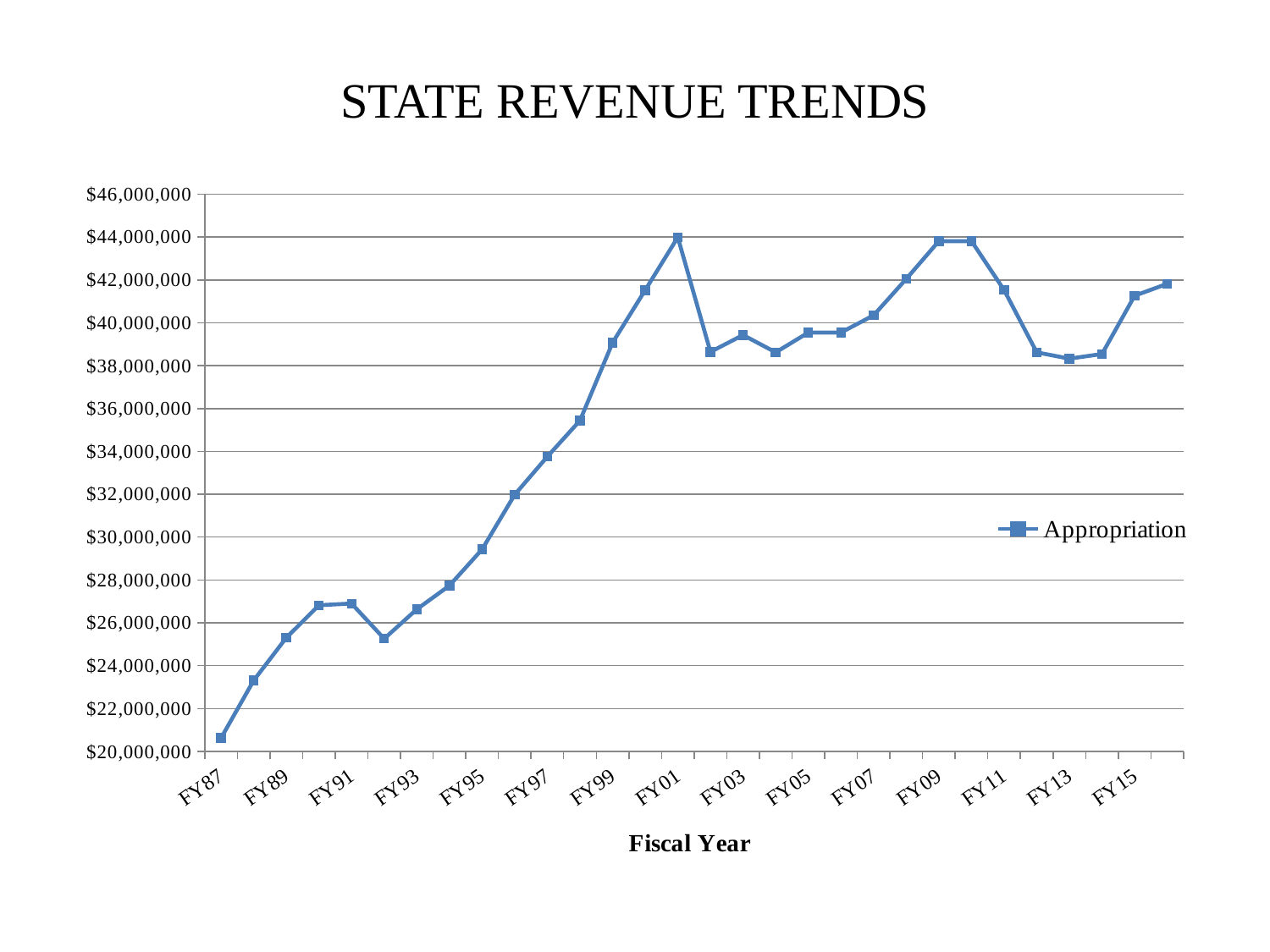
Is the Appropriation value for FY95 greater or less than $30,000,000? less Is the Appropriation value for FY13 greater or less than $40,000,000? less What is the name of the series shown in the legend? Appropriation Does the Appropriation value generally rise or fall from FY87 to FY01? rise Which has the larger Appropriation value, FY01 or FY03? FY01 Is the Appropriation value for FY01 greater or less than $42,000,000? greater What is the title of the chart? STATE REVENUE TRENDS Which fiscal year has the lowest Appropriation value? FY87 How many series does the legend list? 1 What kind of chart is shown on the slide? line chart